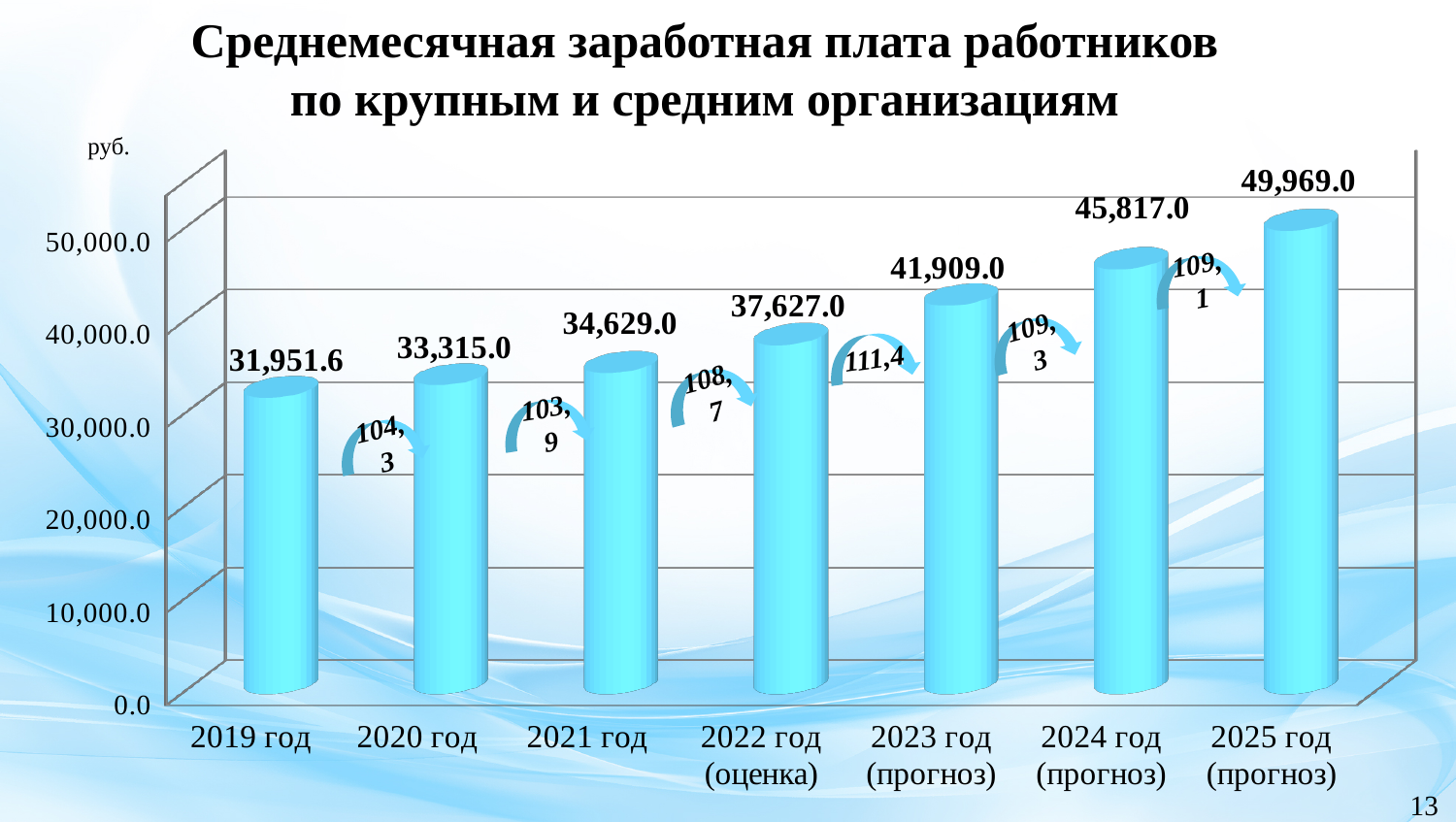
What is the value for 2019 год? 31,951.6 What is the value for 2024 год (прогноз)? 45,817.0 What kind of chart is shown on the slide? bar chart How many years are shown on the x axis? 7 Which is larger, the value for 2021 год or the value for 2023 год (прогноз)? 2023 год (прогноз) Which year has the highest value? 2025 год (прогноз) What is the value for 2022 год (оценка)? 37,627.0 Is the value for 2021 год greater or less than 40,000.0? less Do the values rise or fall from 2019 год to 2025 год? rise What is the difference between the values for 2020 год and 2019 год? 1,363.4 What is the difference between the values for 2025 год (прогноз) and 2024 год (прогноз)? 4,152.0 Which year has the lowest value? 2019 год